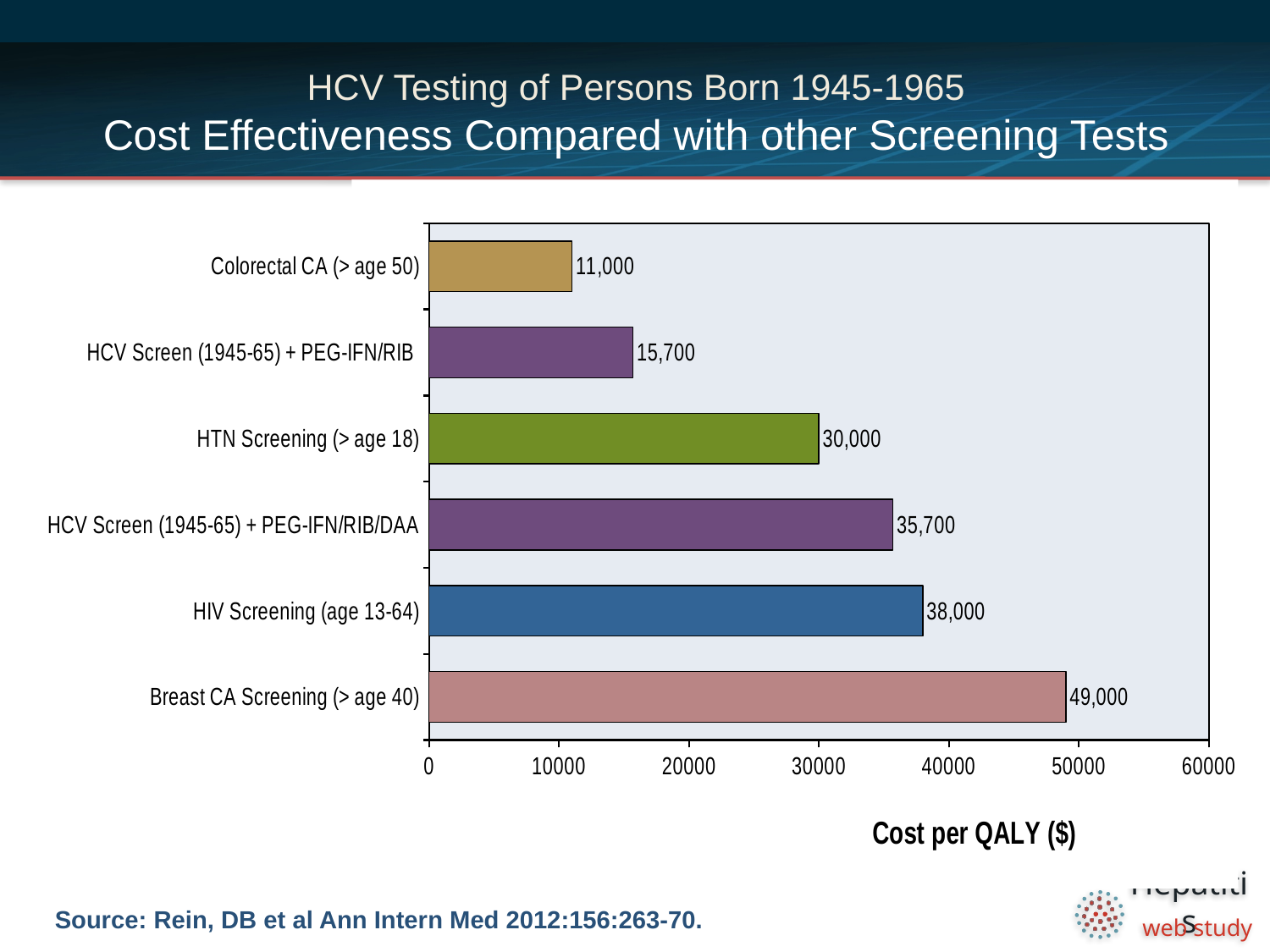
What is the cost per QALY for Colorectal CA (> age 50)? 11,000 What is the cost per QALY for HIV Screening (age 13-64)? 38,000 What is the cost per QALY for HCV Screen (1945-65) + PEG-IFN/RIB? 15,700 How many screening tests are shown in the chart? 6 Is the cost per QALY for Breast CA Screening (> age 40) greater or less than 40000? greater What is the label of the horizontal axis? Cost per QALY ($) Which has a higher cost per QALY, HTN Screening (> age 18) or HIV Screening (age 13-64)? HIV Screening (age 13-64) What is the difference in cost per QALY between HCV Screen (1945-65) + PEG-IFN/RIB/DAA and HCV Screen (1945-65) + PEG-IFN/RIB? 20,000 Which screening test has the lowest cost per QALY? Colorectal CA (> age 50) What kind of chart is shown on the slide? Bar chart Which screening test has the highest cost per QALY? Breast CA Screening (> age 40) What is the difference in cost per QALY between Breast CA Screening (> age 40) and Colorectal CA (> age 50)? 38,000